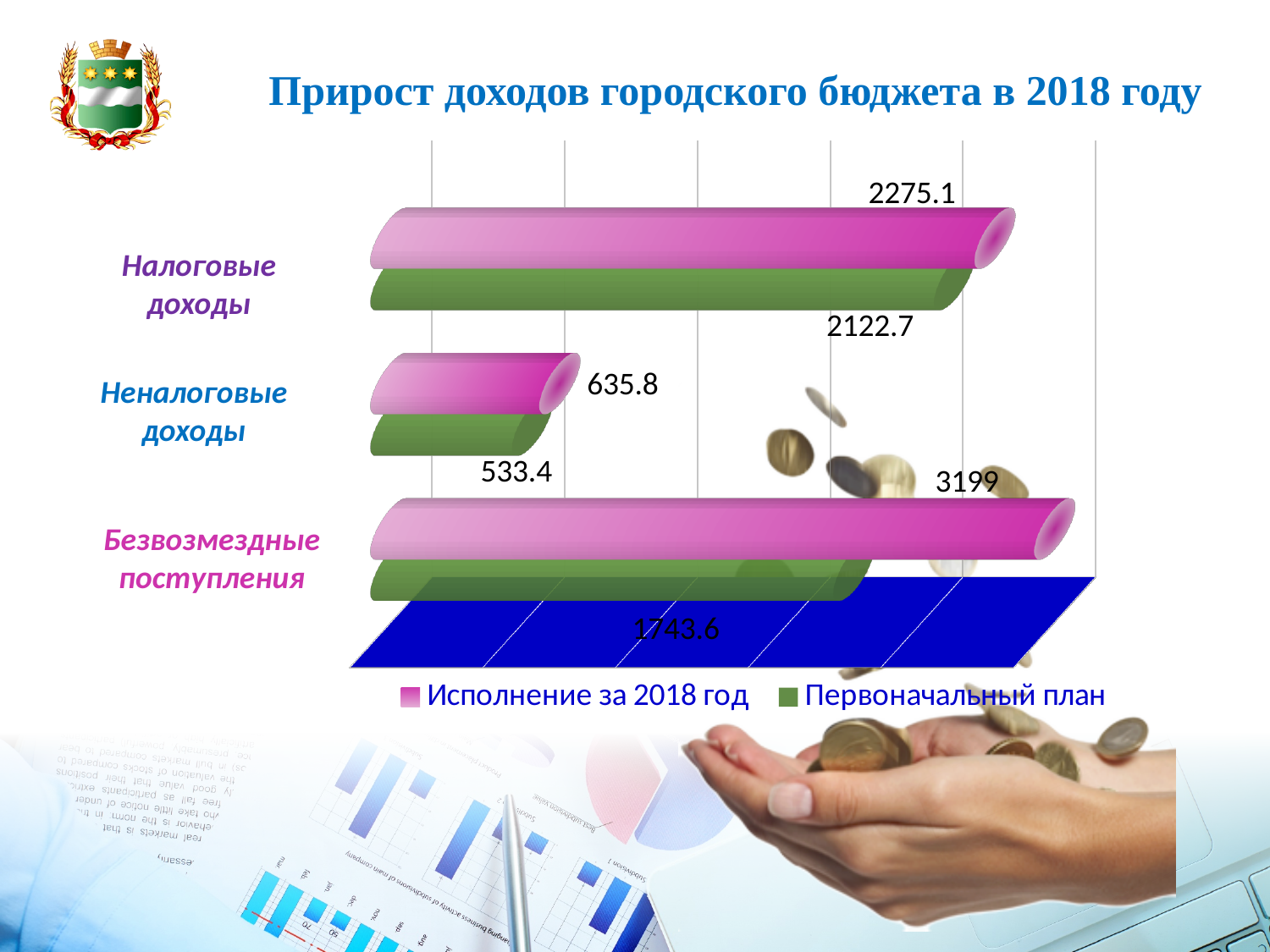
Which category has the lowest value for Первоначальный план? Неналоговые доходы What is the value of Исполнение за 2018 год for Налоговые доходы? 2275.1 How many categories are shown on the chart? 3 What is the value of Первоначальный план for Налоговые доходы? 2122.7 For Налоговые доходы, which is larger: Исполнение за 2018 год or Первоначальный план? Исполнение за 2018 год What is the difference between Исполнение за 2018 год and Первоначальный план for Неналоговые доходы? 102.4 What is the difference between Исполнение за 2018 год and Первоначальный план for Безвозмездные поступления? 1455.4 What is the value of Первоначальный план for Безвозмездные поступления? 1743.6 Which category has the highest value for Исполнение за 2018 год? Безвозмездные поступления How many series does the legend list? 2 What is the value of Исполнение за 2018 год for Неналоговые доходы? 635.8 What type of chart is shown on the slide? Bar chart